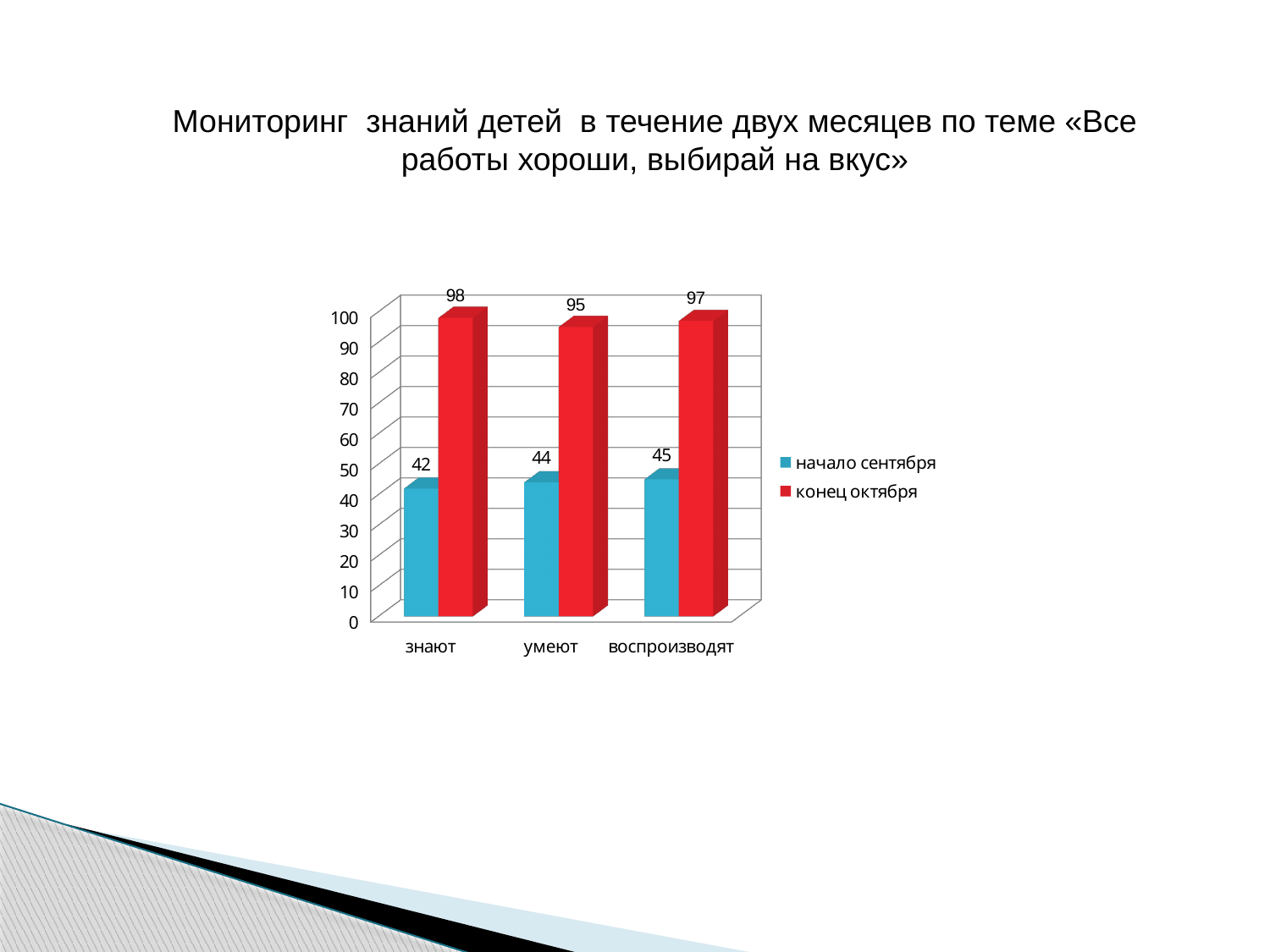
How many series does the legend list? 2 Which category has the lowest value in the "начало сентября" series? знают What is the difference between the "конец октября" and "начало сентября" values for "знают"? 56 What kind of chart is shown on the slide? bar chart What is the value for "знают" in the "начало сентября" series? 42 Is the value for "воспроизводят" in the "конец октября" series greater or less than 90? greater Which is larger for "умеют": the "начало сентября" value or the "конец октября" value? конец октября What is the value for "умеют" in the "конец октября" series? 95 How many categories are shown on the x axis? 3 Which category has the highest value in the "конец октября" series? знают What is the value for "воспроизводят" in the "начало сентября" series? 45 What colour are the bars for the "конец октября" series? red